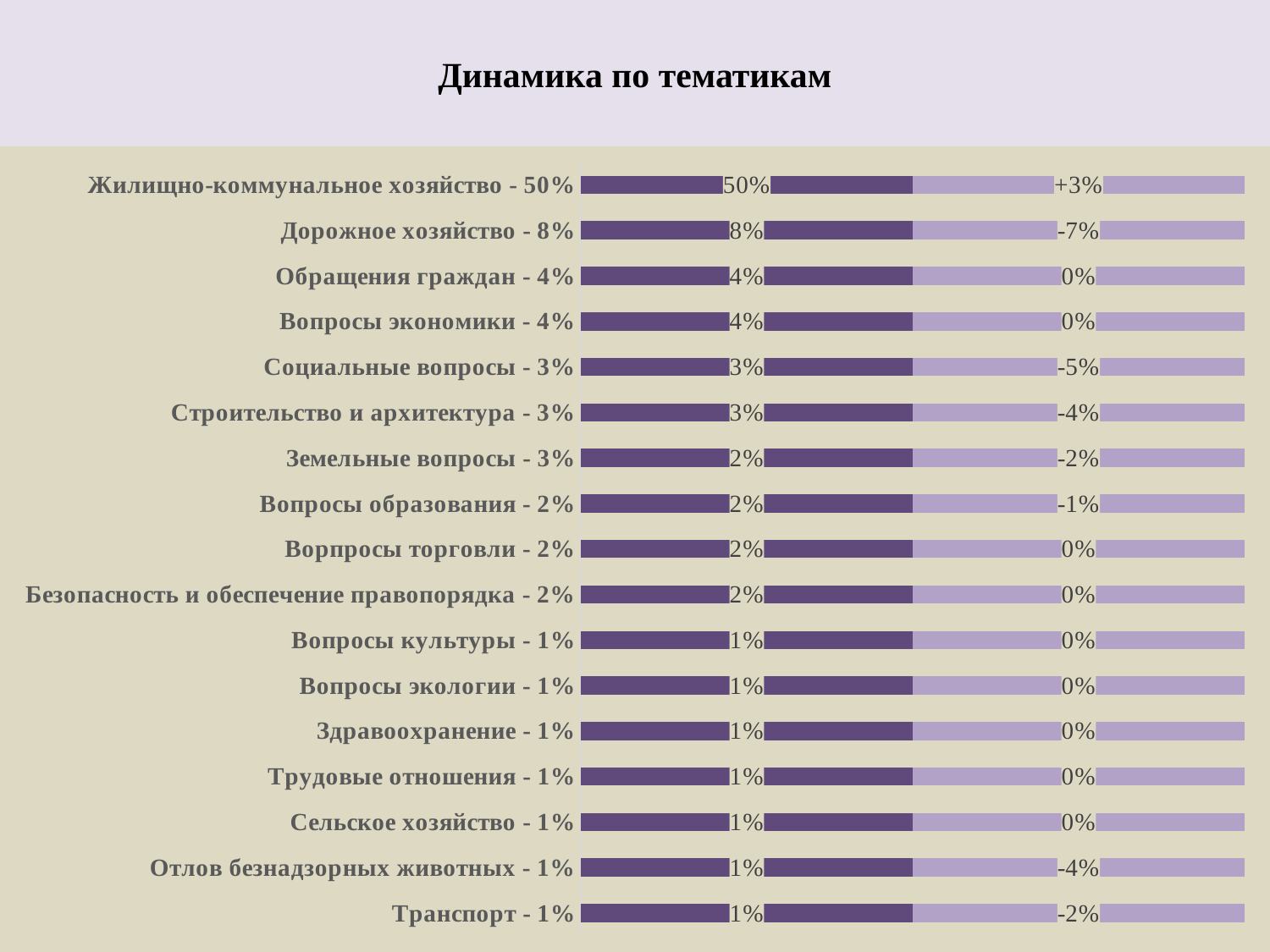
What change value is shown for Жилищно-коммунальное хозяйство? +3% What kind of chart is shown on the slide? Bar chart Which category has the highest percentage share label? Жилищно-коммунальное хозяйство Which has the larger percentage label, Дорожное хозяйство or Обращения граждан? Дорожное хозяйство What is the title of the chart? Динамика по тематикам What is the percentage data label shown for Жилищно-коммунальное хозяйство? 50% What change value is shown for Транспорт? -2% What is the difference between the percentage labels for Жилищно-коммунальное хозяйство and Дорожное хозяйство? 42 percentage points How many categories are listed on the chart? 17 What change value is shown for Дорожное хозяйство? -7% What change value is shown for Отлов безнадзорных животных? -4% What change value is shown for Социальные вопросы? -5%